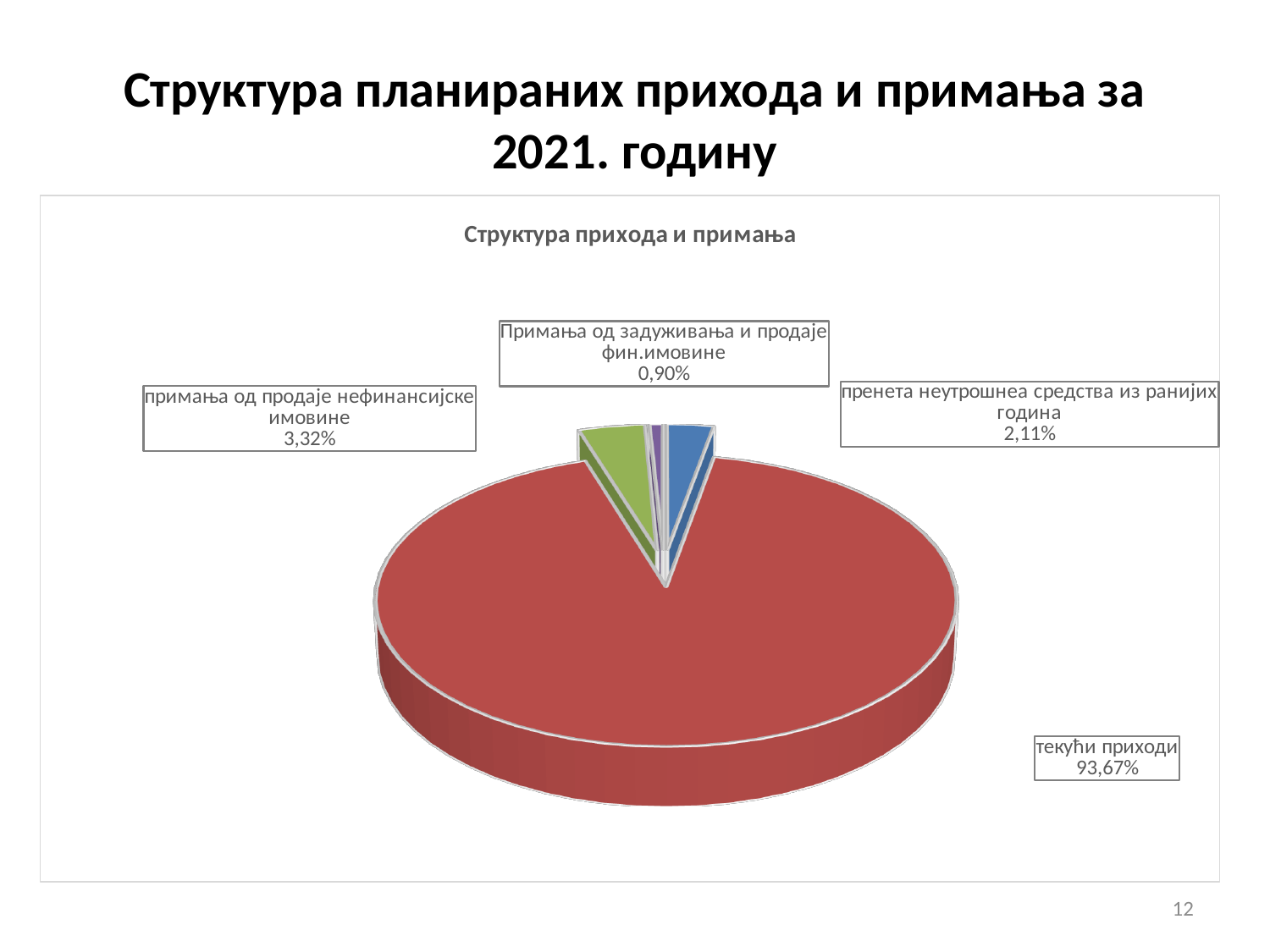
What colour is the slice for текући приходи? red What share of the pie is labelled for пренета неутрошнеа средства из ранијих година? 2,11% Which is larger: the share for примања од продаје нефинансијске имовине or the share for пренета неутрошнеа средства из ранијих година? примања од продаје нефинансијске имовине What share of the pie is labelled for текући приходи? 93,67% How many slices does the pie chart have? 4 Which category has the smallest slice of the pie? Примања од задуживања и продаје фин.имовине What share of the pie is labelled for примања од продаје нефинансијске имовине? 3,32% What kind of chart is shown on the slide? pie chart What is the difference between the share for примања од продаје нефинансијске имовине and the share for пренета неутрошнеа средства из ранијих година? 1,21% What is the title of the chart? Структура прихода и примања Which category has the largest slice of the pie? текући приходи